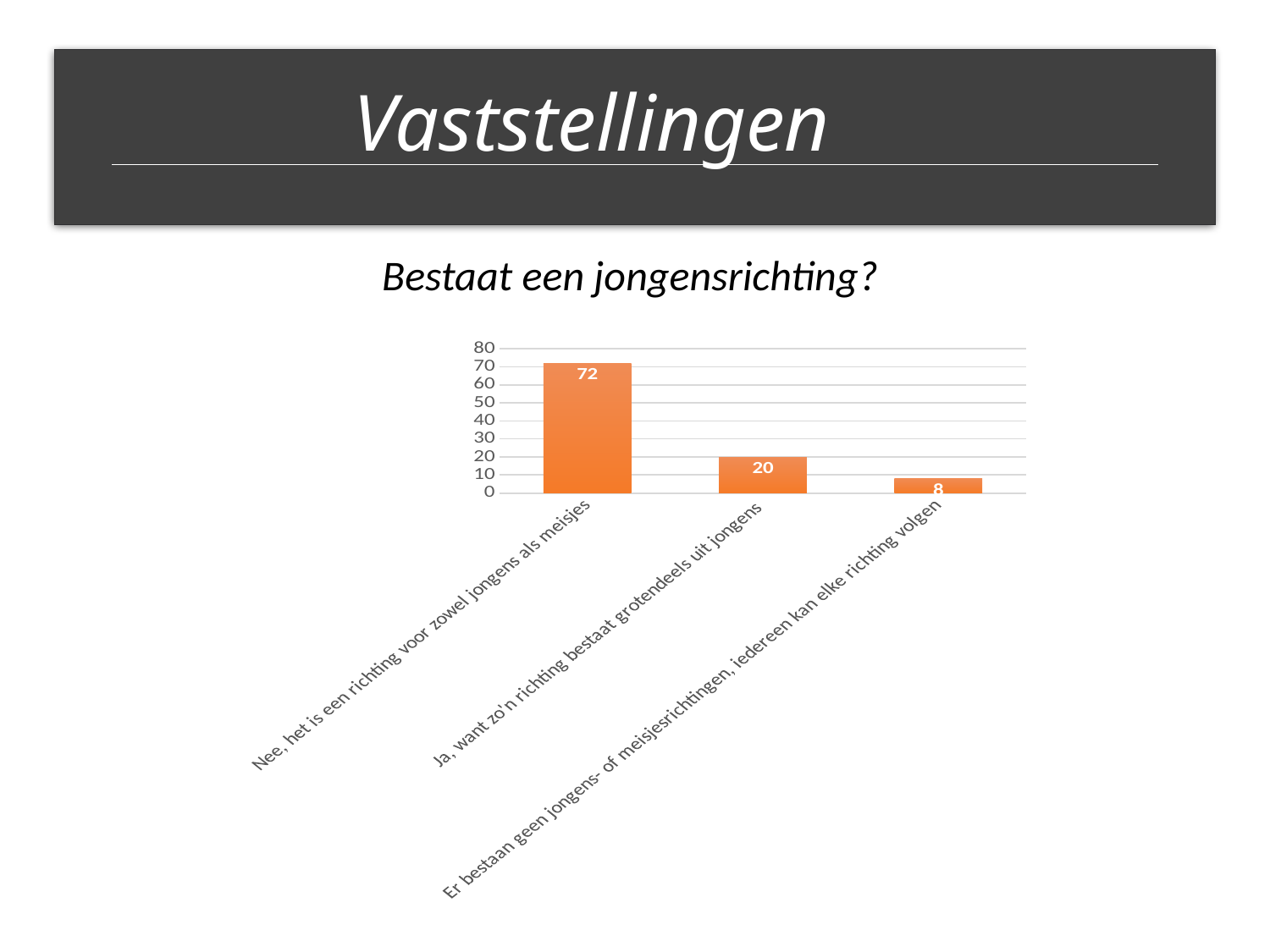
Which category has the highest value? Nee, het is een richting voor zowel jongens als meisjes Which is larger: the value for 'Ja, want zo'n richting bestaat grotendeels uit jongens' or for 'Er bestaan geen jongens- of meisjesrichtingen, iedereen kan elke richting volgen'? Ja, want zo'n richting bestaat grotendeels uit jongens What is the difference between the values for 'Ja, want zo'n richting bestaat grotendeels uit jongens' and 'Er bestaan geen jongens- of meisjesrichtingen, iedereen kan elke richting volgen'? 12 What is the difference between the values for 'Nee, het is een richting voor zowel jongens als meisjes' and 'Ja, want zo'n richting bestaat grotendeels uit jongens'? 52 What is the value for 'Nee, het is een richting voor zowel jongens als meisjes'? 72 What is the value for 'Ja, want zo'n richting bestaat grotendeels uit jongens'? 20 Is the value for 'Nee, het is een richting voor zowel jongens als meisjes' greater or less than 50? greater How many categories are shown in the chart? 3 What kind of chart is shown on the slide? bar chart What is the value for 'Er bestaan geen jongens- of meisjesrichtingen, iedereen kan elke richting volgen'? 8 Which category has the lowest value? Er bestaan geen jongens- of meisjesrichtingen, iedereen kan elke richting volgen Do the values rise or fall from left to right across the categories? fall